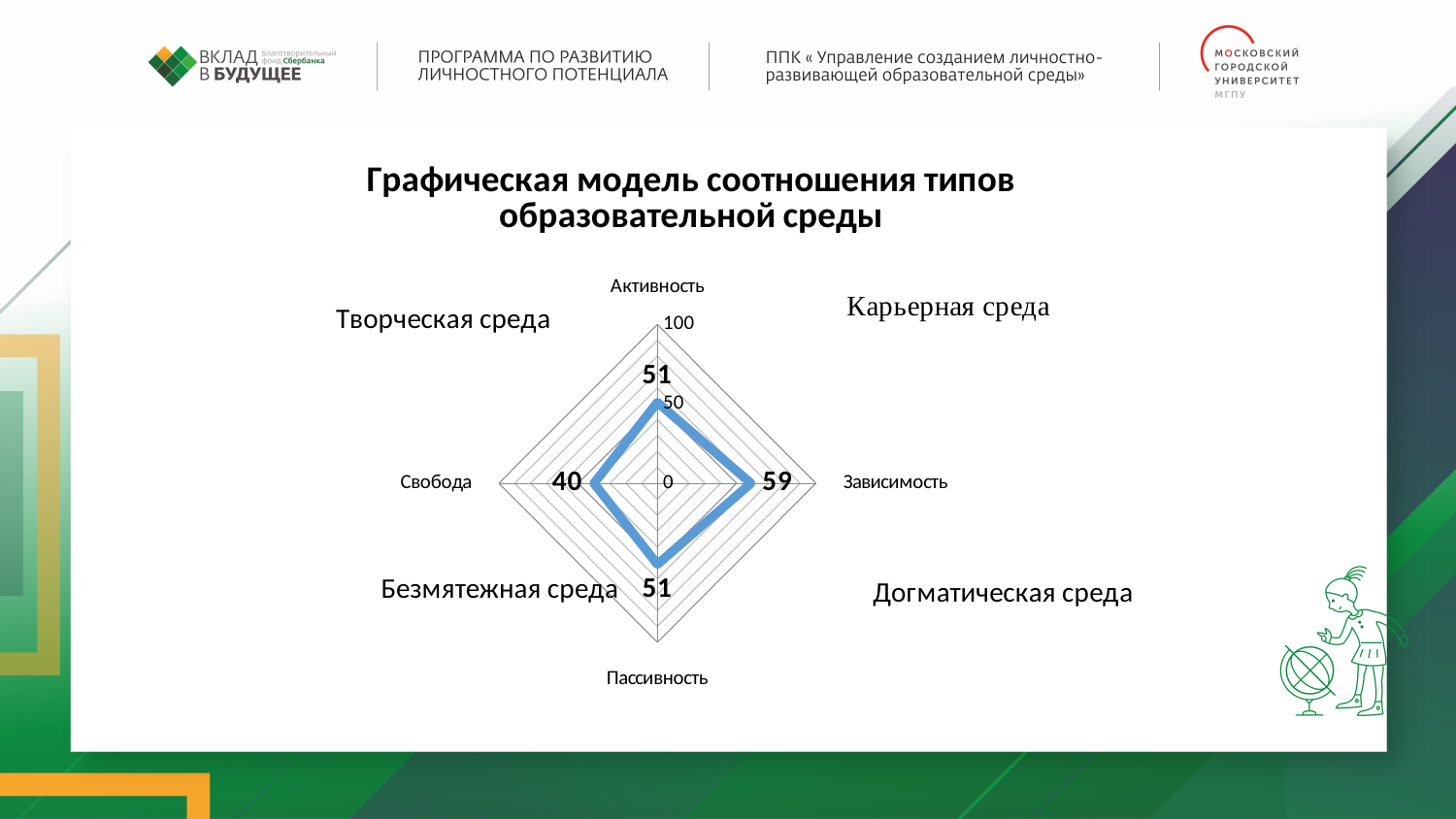
What is the value for Активность on the radar chart? 51 Which axis has the highest value on the radar chart? Зависимость What is the value for Пассивность on the radar chart? 51 What is the value for Свобода on the radar chart? 40 What kind of chart is shown on the slide? Radar chart What is the title of the chart on the slide? Графическая модель соотношения типов образовательной среды Is the value for Свобода greater or less than 50? less Which axis has the lowest value on the radar chart? Свобода What is the value for Зависимость on the radar chart? 59 Which is larger, the value for Зависимость or the value for Активность? Зависимость What is the difference between the values for Зависимость and Свобода? 19 How many axes (categories) does the radar chart have? 4